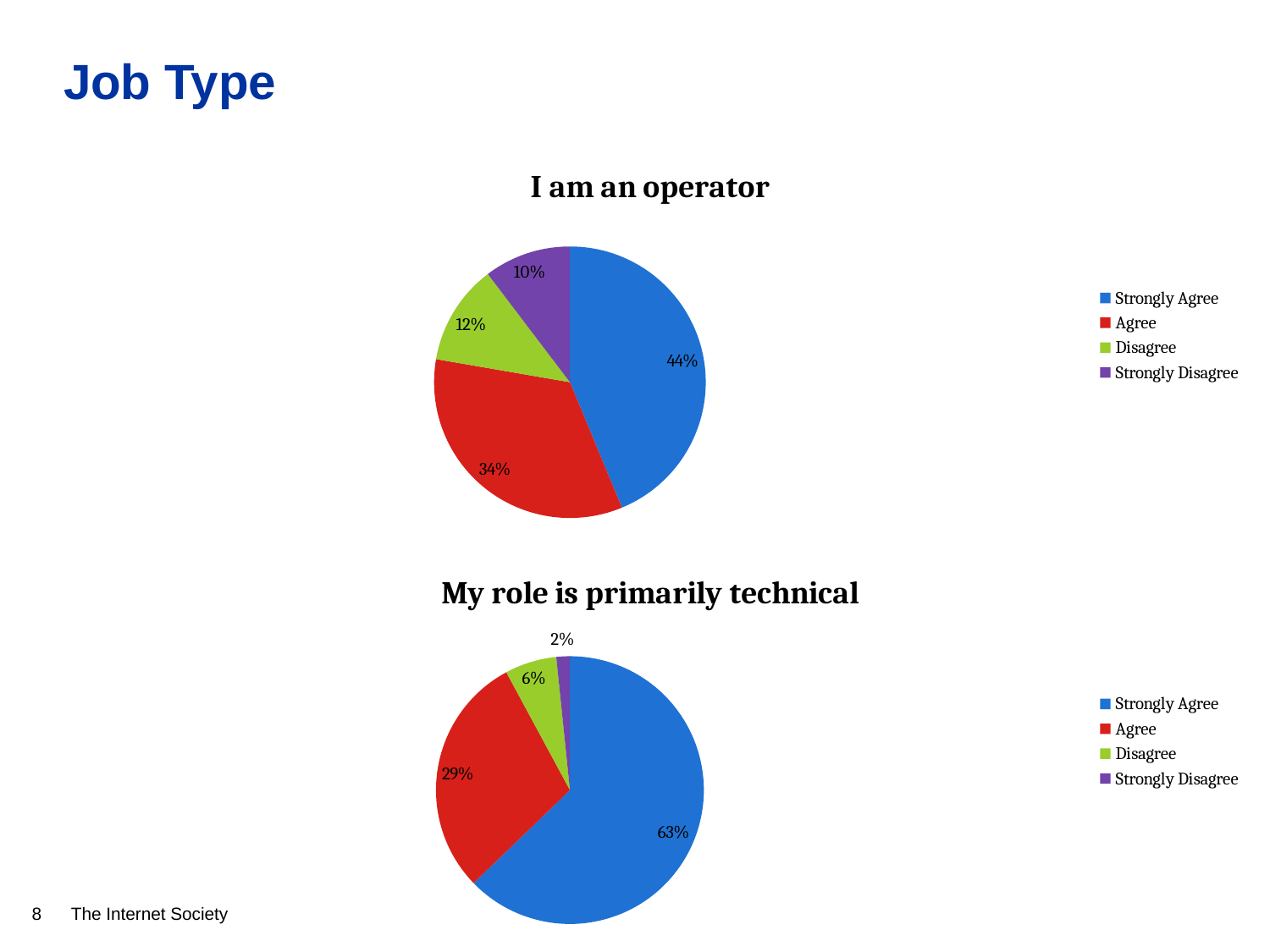
In the 'I am an operator' chart, what percentage of respondents chose Strongly Disagree? 10% In the 'I am an operator' chart, which response has the largest share? Strongly Agree In the 'I am an operator' chart, what percentage of respondents chose Agree? 34% How many categories does the legend of the 'My role is primarily technical' chart list? 4 In the 'My role is primarily technical' chart, what percentage of respondents chose Disagree? 6% What type of chart is the 'I am an operator' chart? Pie chart In the 'My role is primarily technical' chart, which response has the smallest share? Strongly Disagree In the 'I am an operator' chart, what is the difference between the Strongly Agree and Agree shares? 10% In the 'I am an operator' chart, what percentage of respondents chose Strongly Agree? 44% Which chart has a larger Strongly Agree share, 'I am an operator' or 'My role is primarily technical'? My role is primarily technical In the 'My role is primarily technical' chart, what is the difference between the Strongly Agree and Agree shares? 34% In the 'My role is primarily technical' chart, what percentage of respondents chose Strongly Agree? 63%